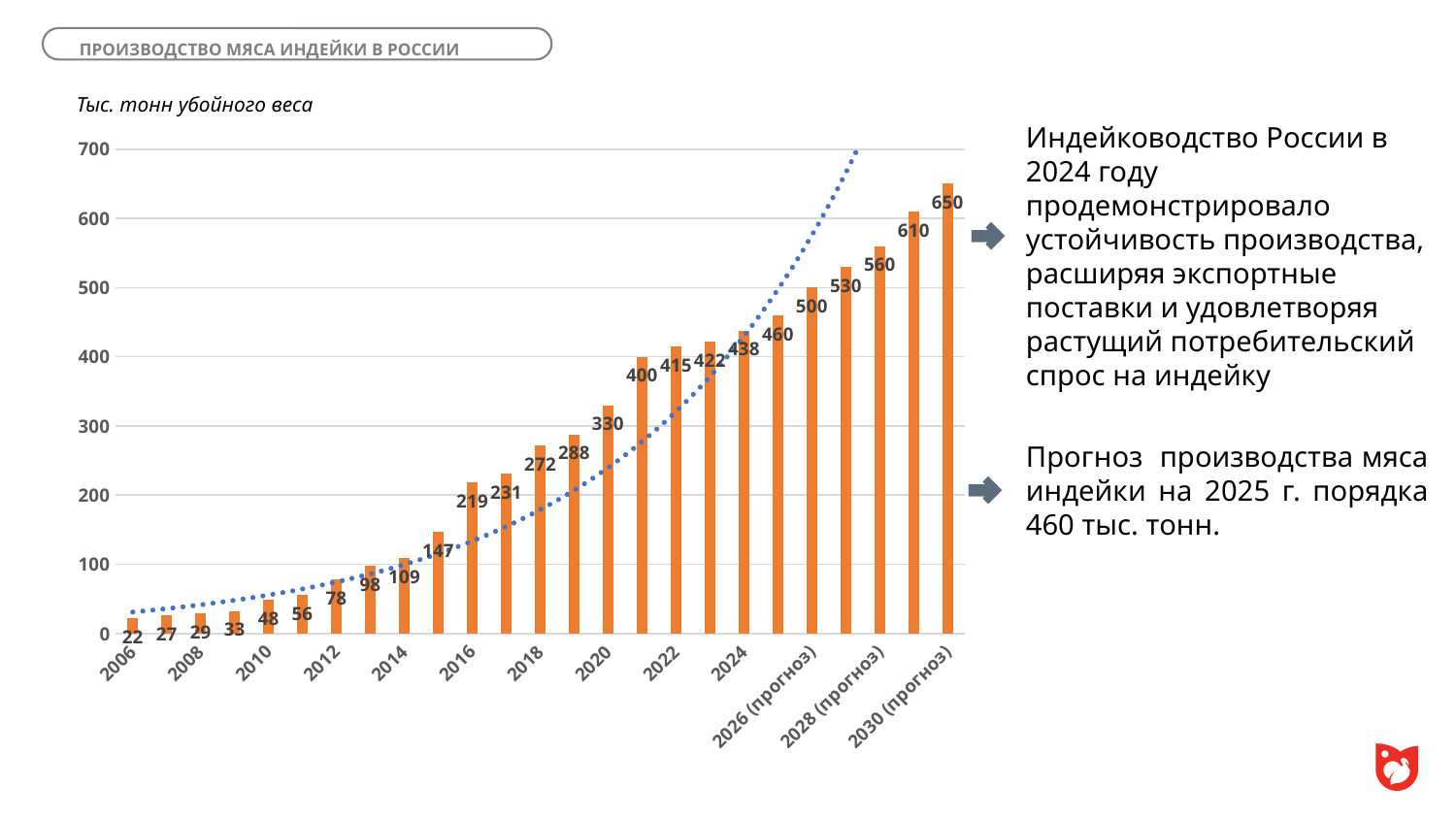
Which year has the lowest value? 2006 Which year has the highest value? 2030 (прогноз) What is the value for 2016? 219 What is the difference between the values for 2020 and 2010? 282 What is the value for 2024? 438 How many bars are plotted in the chart? 25 Which is larger, the value for 2018 or the value for 2022? 2022 Do the values rise or fall from 2006 to 2030? rise Is the value for 2028 (прогноз) greater or less than 500? greater What is the value for 2030 (прогноз)? 650 What is the value for 2006? 22 What kind of chart is shown? bar chart